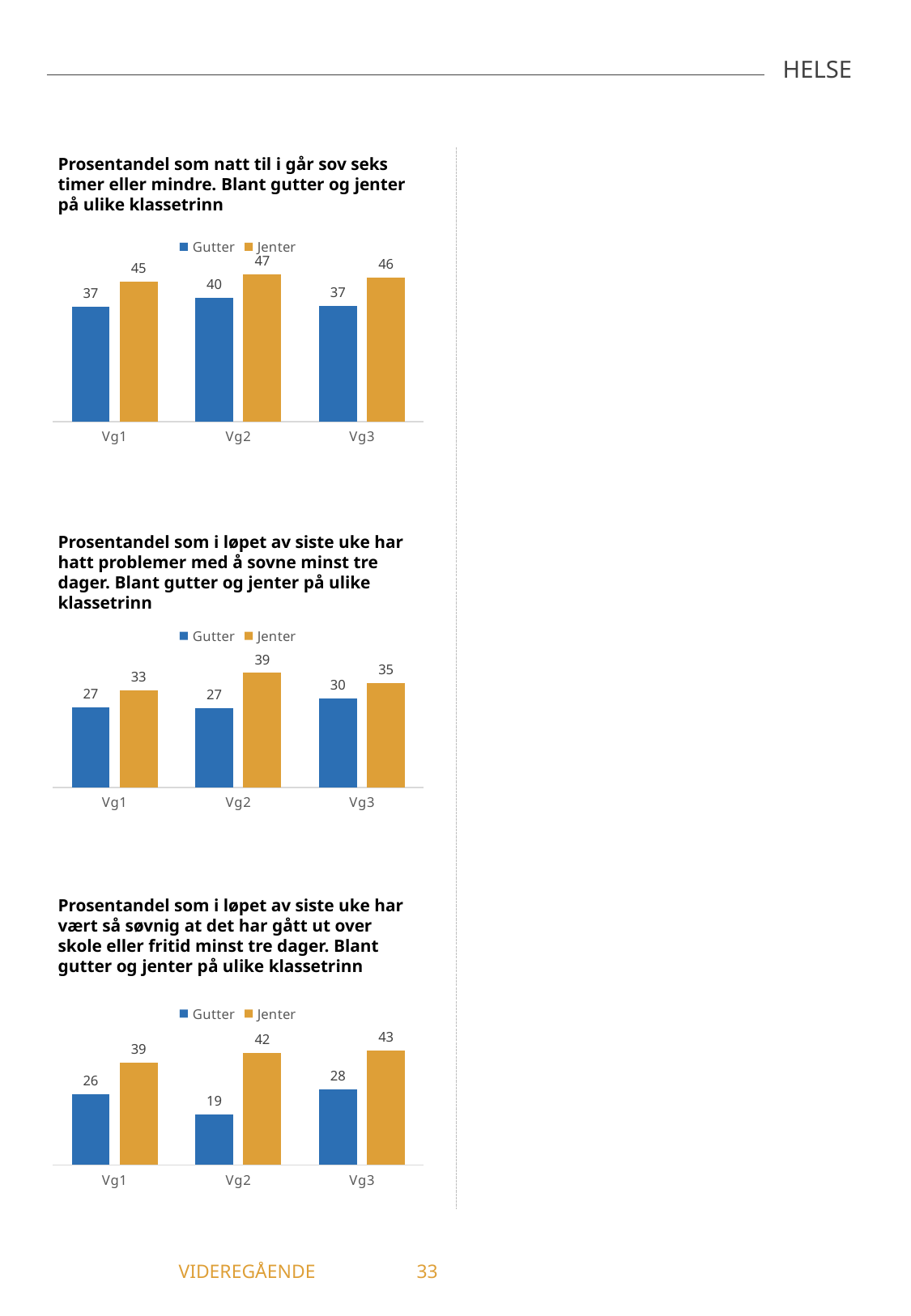
How many series does the legend of the bottom chart list? 2 In the bottom chart (so sleepy it affected school or leisure), what is the difference between Jenter and Gutter in Vg2? 23 In the middle chart (problems falling asleep), what is the value for Jenter in Vg2? 39 What kind of chart is the middle chart? Bar chart In the top chart (sleeping six hours or less), what is the difference between Jenter and Gutter in Vg3? 9 In the bottom chart (so sleepy it affected school or leisure), what is the value for Gutter in Vg2? 19 In the bottom chart (so sleepy it affected school or leisure), which category has the highest value for Jenter? Vg3 In the top chart (sleeping six hours or less), what is the value for Gutter in Vg1? 37 In the middle chart (problems falling asleep), which category has the lowest value for Jenter? Vg1 In the middle chart (problems falling asleep), what is the difference between Jenter and Gutter in Vg1? 6 In the top chart (sleeping six hours or less), which category has the highest value for Jenter? Vg2 In the top chart (sleeping six hours or less), what is the value for Jenter in Vg2? 47